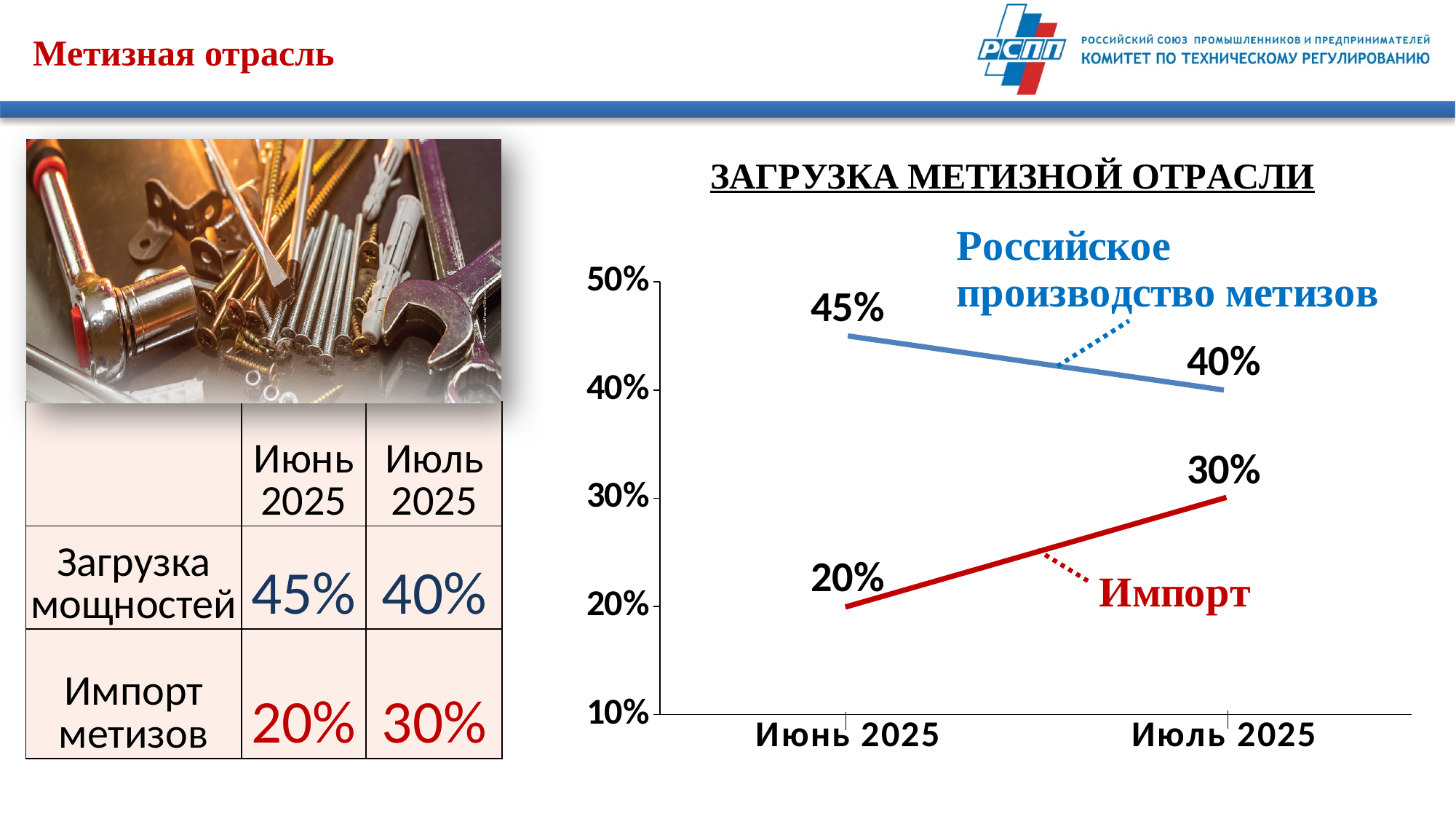
What is the difference between Российское производство метизов and Импорт in Июль 2025? 10% What is the value for Российское производство метизов in Июнь 2025? 45% Does the Российское производство метизов line rise or fall from Июнь 2025 to Июль 2025? fall By how much did Импорт change from Июнь 2025 to Июль 2025? 10% Which series has the higher value in Июнь 2025, Российское производство метизов or Импорт? Российское производство метизов How many series are plotted on the chart? 2 What is the value for Импорт in Июнь 2025? 20% How many time points are shown on the x axis of the chart? 2 What is the value for Российское производство метизов in Июль 2025? 40% What type of chart is shown on the slide? line chart What is the value for Импорт in Июль 2025? 30% Does the Импорт line rise or fall from Июнь 2025 to Июль 2025? rise